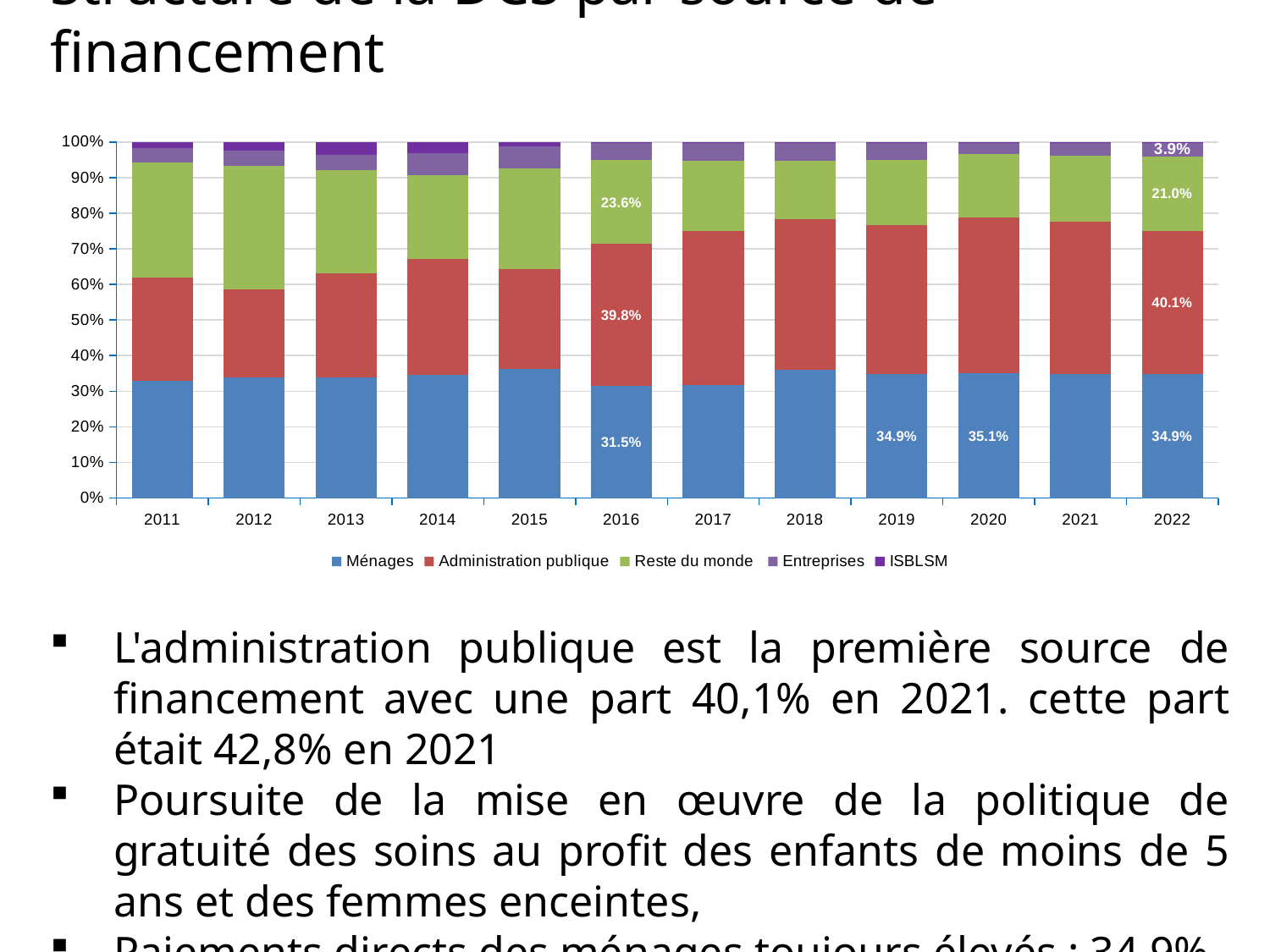
Which year has the larger Administration publique share, 2016 or 2022? 2022 How many series does the legend list? 5 What is the share of Administration publique in 2022? 40.1% What is the share of Administration publique in 2016? 39.8% Is the share of Ménages in 2011 greater or less than 40%? less What is the share of Ménages in 2020? 35.1% How many years are shown on the x axis? 12 What is the share of Reste du monde in 2022? 21.0% What is the difference between the Ménages share in 2020 and in 2019? 0.2% What kind of chart is shown on the slide? Stacked bar chart What is the share of Ménages in 2016? 31.5% What is the share of Reste du monde in 2016? 23.6%